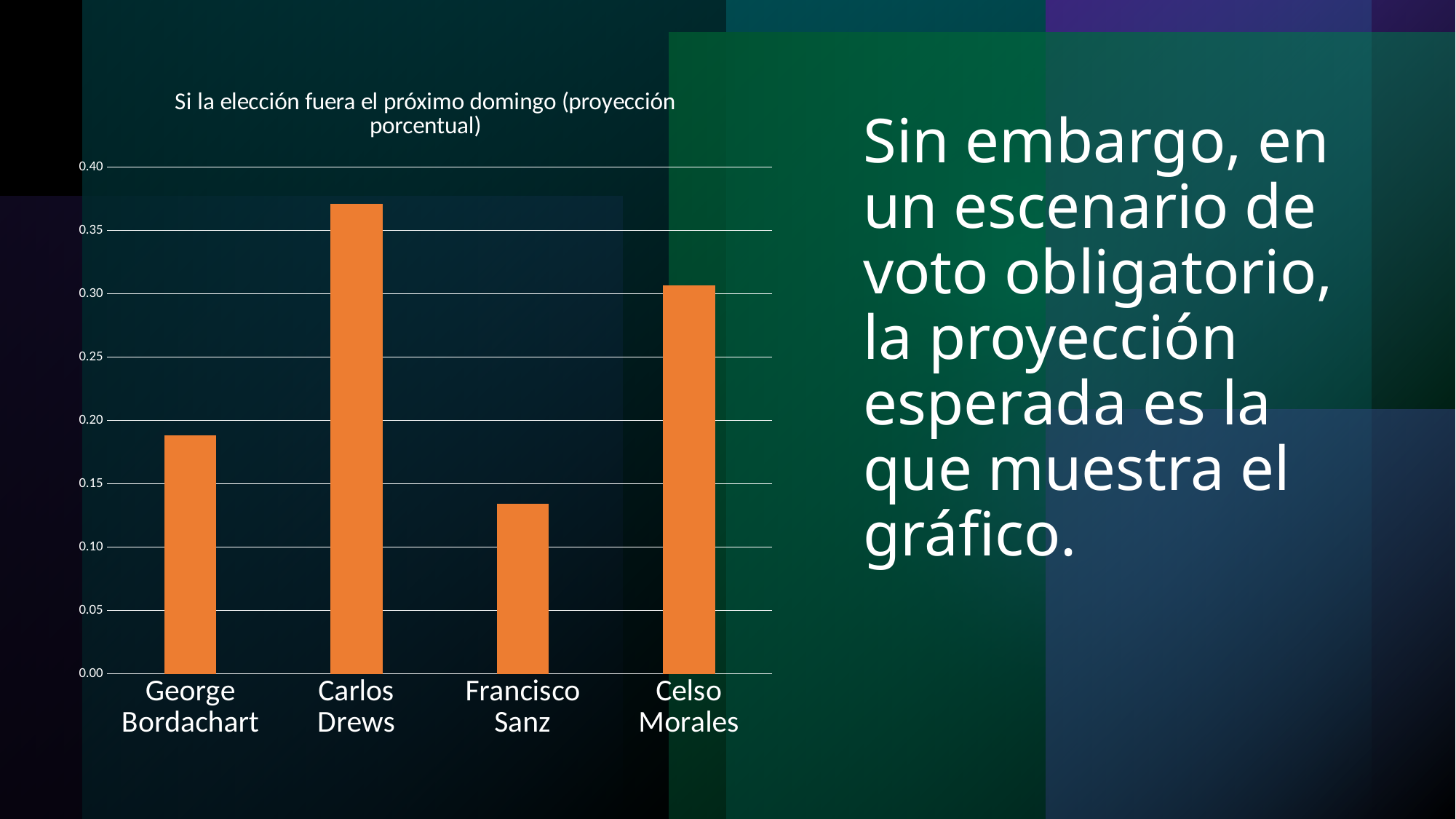
How many candidates are shown on the chart? 4 Is the value for George Bordachart greater or less than 0.15? greater Is the value for Carlos Drews greater or less than 0.35? greater Is the value for Celso Morales greater or less than 0.35? less Which is larger, the value for Carlos Drews or the value for Celso Morales? Carlos Drews What kind of chart is shown on the slide? bar chart Which candidate has the lowest projected value? Francisco Sanz Which candidate has the highest projected value? Carlos Drews What colour are the bars in the chart? orange Which is larger, the value for Celso Morales or the value for George Bordachart? Celso Morales What is the title of the chart? Si la elección fuera el próximo domingo (proyección porcentual)